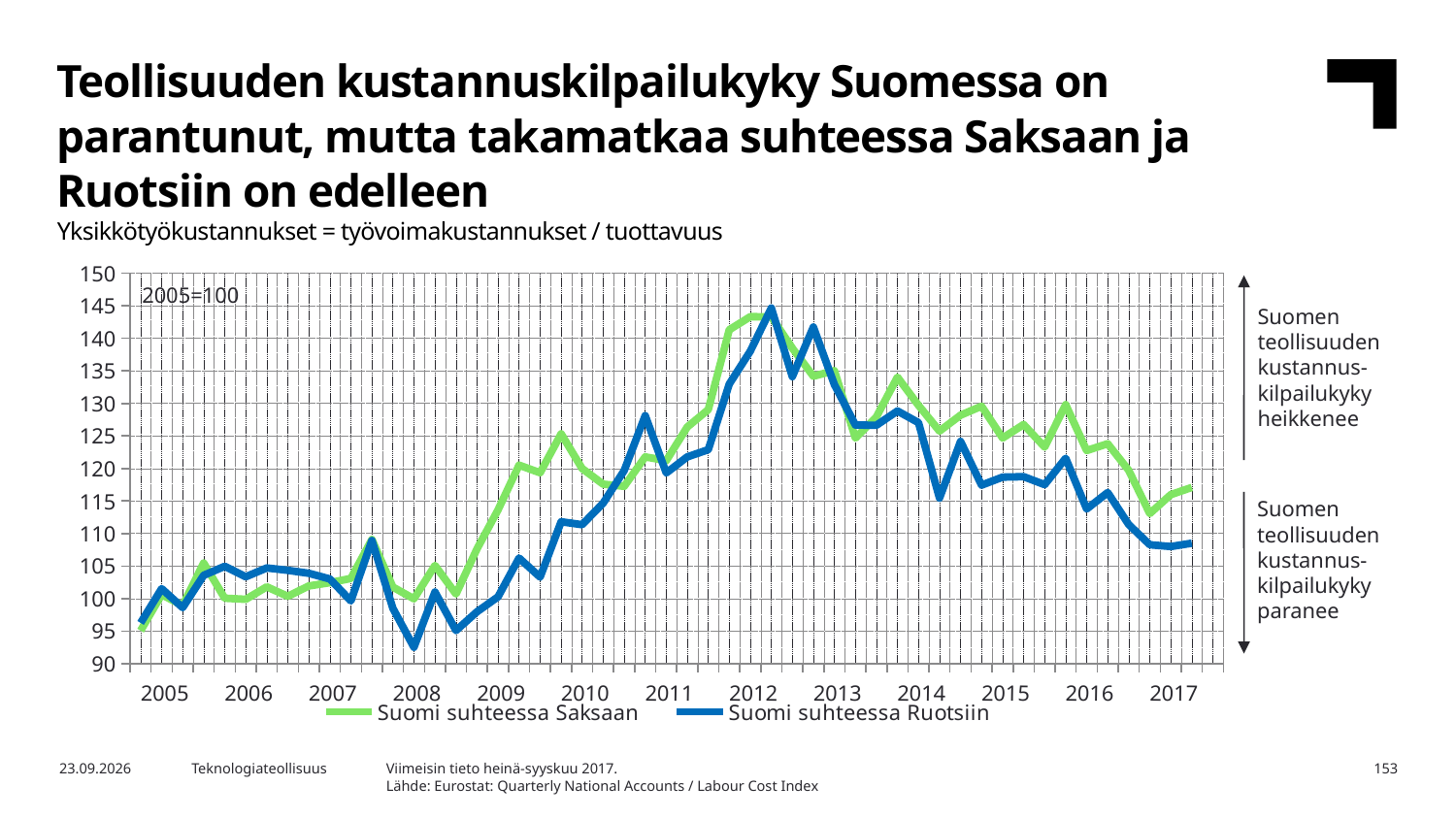
Is the peak value of Suomi suhteessa Ruotsiin in 2012 greater or less than 140? greater In which year do both series reach their highest values? 2012 What kind of chart is shown on the slide? line chart How many series does the legend list? 2 At the end of 2017, which series has the higher value, Suomi suhteessa Saksaan or Suomi suhteessa Ruotsiin? Suomi suhteessa Saksaan How many years are labelled on the x axis? 13 Is the value for Suomi suhteessa Ruotsiin at the end of 2017 greater or less than 115? less Is the lowest value of Suomi suhteessa Ruotsiin, reached in 2008, greater or less than 95? less Do the values of both series rise or fall between 2012 and 2017? fall What are the two series named in the legend? Suomi suhteessa Saksaan; Suomi suhteessa Ruotsiin What base year and value does the index use, as noted on the chart? 2005=100